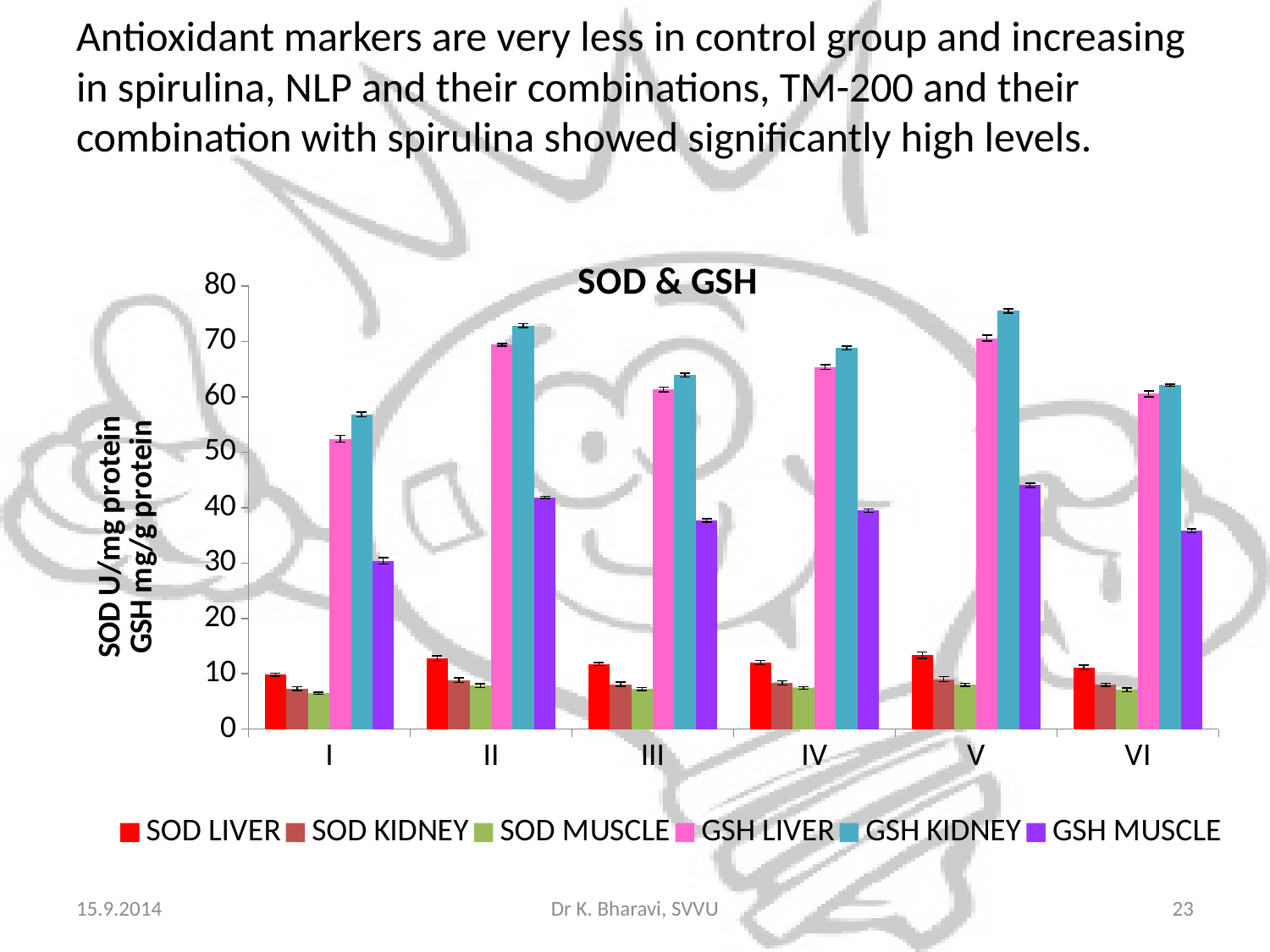
How many groups are shown along the x axis of the SOD & GSH chart? 6 How many series does the legend of the SOD & GSH chart list? 6 Which group has the lowest GSH LIVER value? I Which is larger, the GSH LIVER value for group II or for group III? group II Is the GSH LIVER value for group I greater or less than 60? less Is the GSH KIDNEY value for group V greater or less than 70? greater Which group has the highest GSH KIDNEY value? V What kind of chart is shown on the slide? bar chart Is the SOD LIVER value for group V greater or less than 10? greater What is the title of the chart? SOD & GSH In group I, which is larger, the GSH KIDNEY value or the GSH LIVER value? GSH KIDNEY